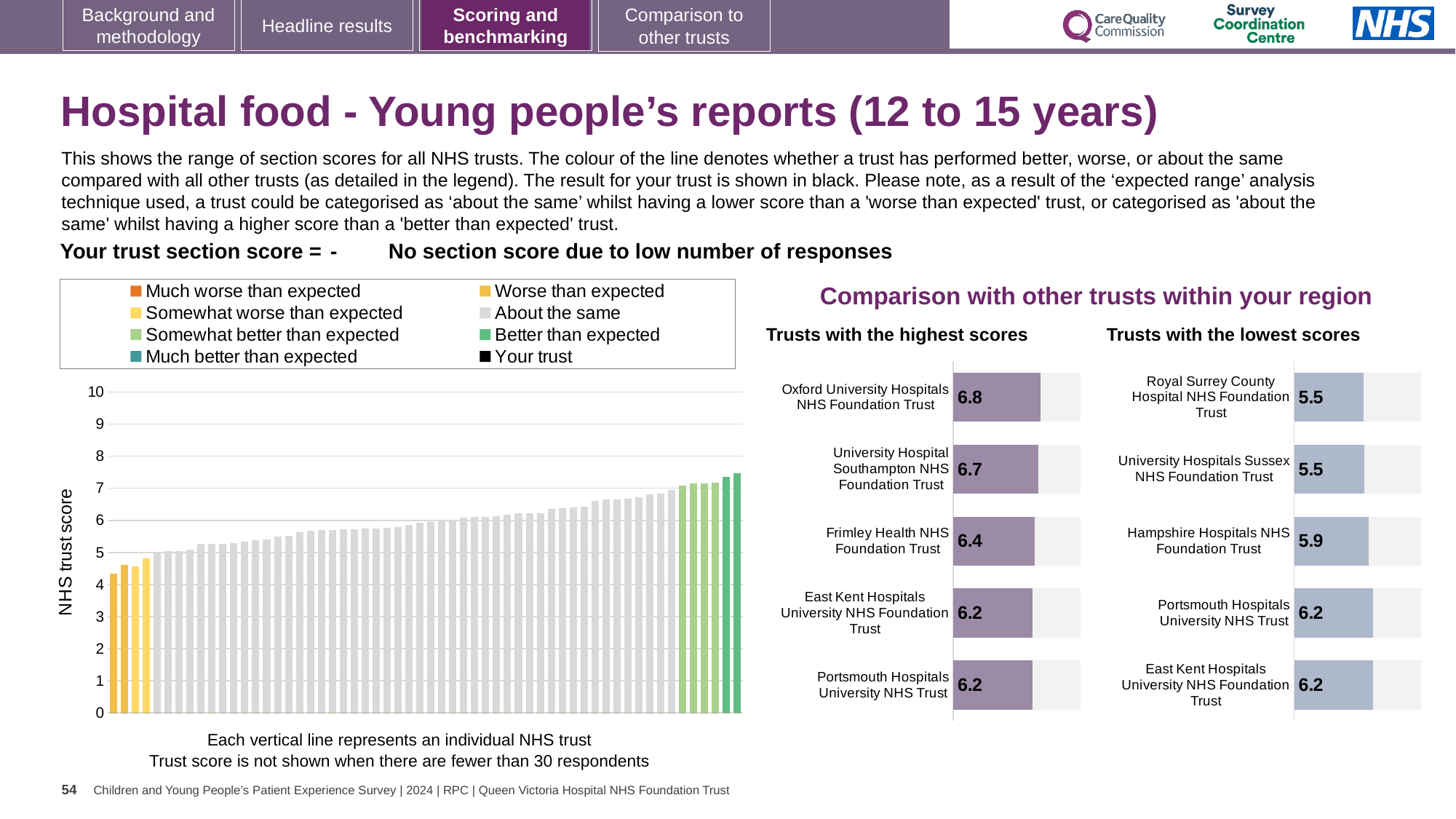
In the 'Trusts with the highest scores' chart, what is the score for Oxford University Hospitals NHS Foundation Trust? 6.8 In the 'Trusts with the highest scores' chart, what is the score for Frimley Health NHS Foundation Trust? 6.4 In the 'Trusts with the highest scores' chart, which has the higher score: University Hospital Southampton NHS Foundation Trust or East Kent Hospitals University NHS Foundation Trust? University Hospital Southampton NHS Foundation Trust In the 'Trusts with the lowest scores' chart, what is the score for Hampshire Hospitals NHS Foundation Trust? 5.9 How many entries does the legend above the large 'NHS trust score' chart list? 8 In the 'Trusts with the lowest scores' chart, what is the difference between the scores of Hampshire Hospitals NHS Foundation Trust and Royal Surrey County Hospital NHS Foundation Trust? 0.4 In the large 'NHS trust score' chart on the left, do the bar values rise or fall from left to right? Rise How many trusts are listed in the 'Trusts with the lowest scores' chart? 5 In the 'Trusts with the highest scores' chart, which trust has the highest score? Oxford University Hospitals NHS Foundation Trust In the 'Trusts with the highest scores' chart, what is the difference between the scores of Oxford University Hospitals NHS Foundation Trust and Frimley Health NHS Foundation Trust? 0.4 In the large 'NHS trust score' chart on the left, is the value of the leftmost bar greater or less than 5? less What kind of chart is the large 'NHS trust score' chart on the left of the slide? Bar chart